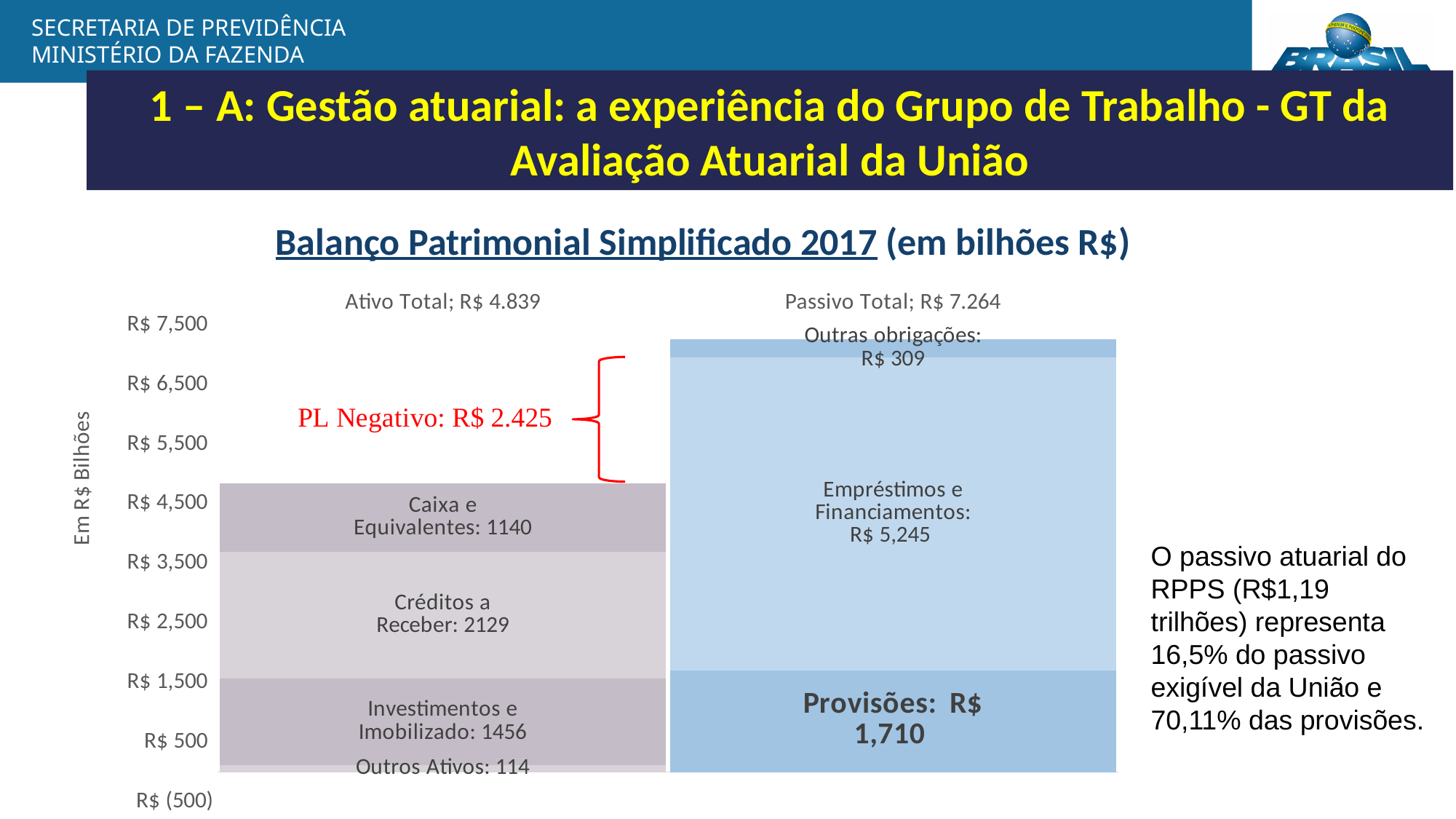
What is the value of the Empréstimos e Financiamentos segment in the Passivo Total bar? R$ 5,245 Which bar is taller, Ativo Total or Passivo Total? Passivo Total What is the value of the Provisões segment? R$ 1,710 What is the value of the Caixa e Equivalentes segment in the Ativo Total bar? 1140 What is the total of the Passivo Total bar? R$ 7.264 What is the value of the Investimentos e Imobilizado segment? 1456 What kind of chart is shown on the slide? Stacked bar chart Which segment of the Ativo Total bar is the largest? Créditos a Receber What is the value of the Outras obrigações segment? R$ 309 What is the value of the Créditos a Receber segment? 2129 What is the value of the Outros Ativos segment? 114 What is the total of the Ativo Total bar? R$ 4.839